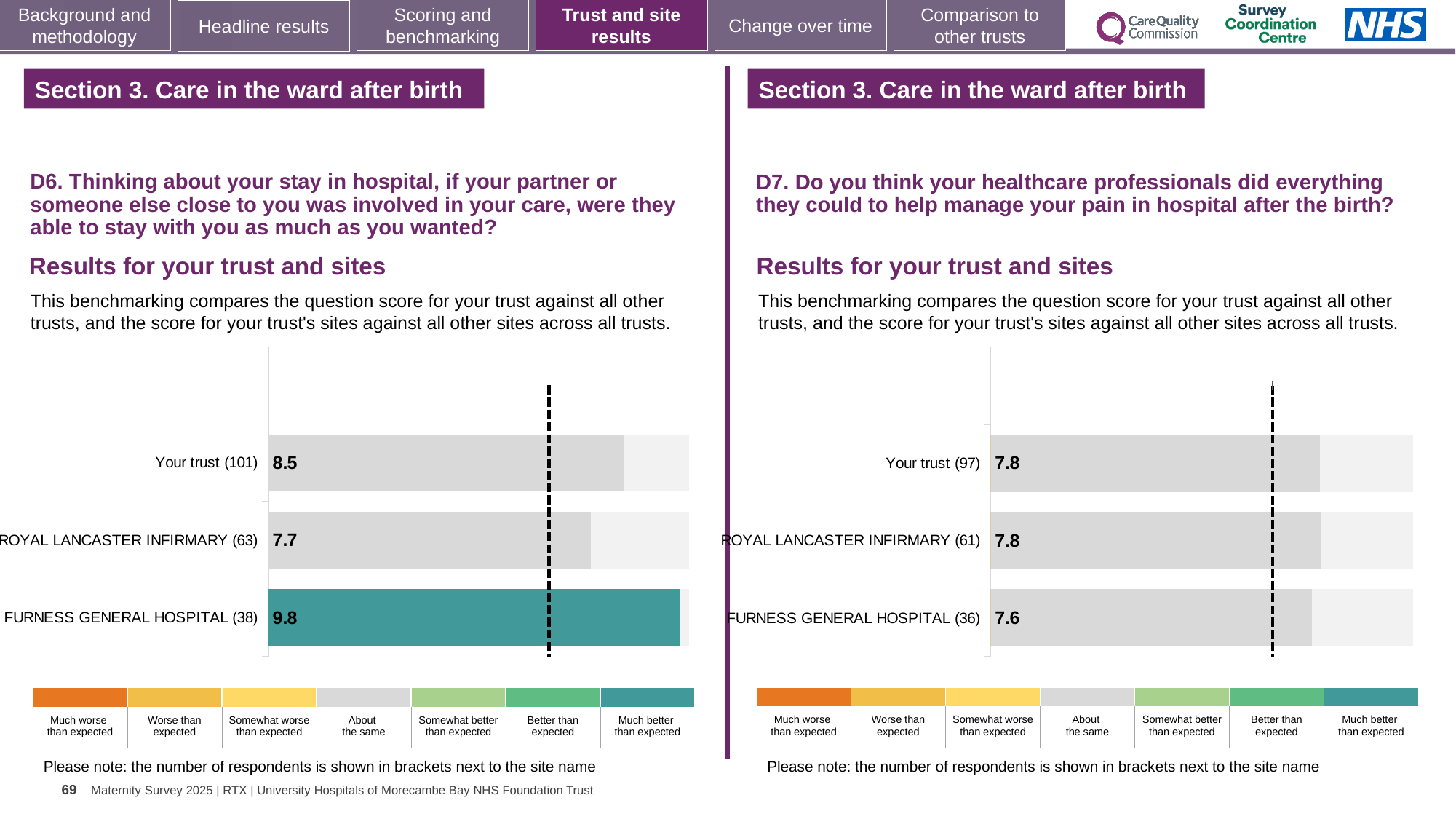
On the D7 chart (right), what is the score for Your trust? 7.8 On the D6 chart (left), what is the difference between the scores for Furness General Hospital and Royal Lancaster Infirmary? 2.1 On the D7 chart (right), how many bars are plotted? 3 What kind of chart is used on the D6 chart (left)? Bar chart On the D6 chart (left), what is the score for Your trust? 8.5 On the D6 chart (left), what is the score for Royal Lancaster Infirmary? 7.7 On the D6 chart (left), which benchmark category does the coloured bar for Furness General Hospital fall into according to the legend? Much better than expected On the D7 chart (right), which site has the lowest score? Furness General Hospital On the D7 chart (right), what is the score for Furness General Hospital? 7.6 On the D6 chart (left), which site or trust has the highest score? Furness General Hospital On the D6 chart (left), which site or trust has the lowest score? Royal Lancaster Infirmary On the D6 chart (left), what is the score for Furness General Hospital? 9.8